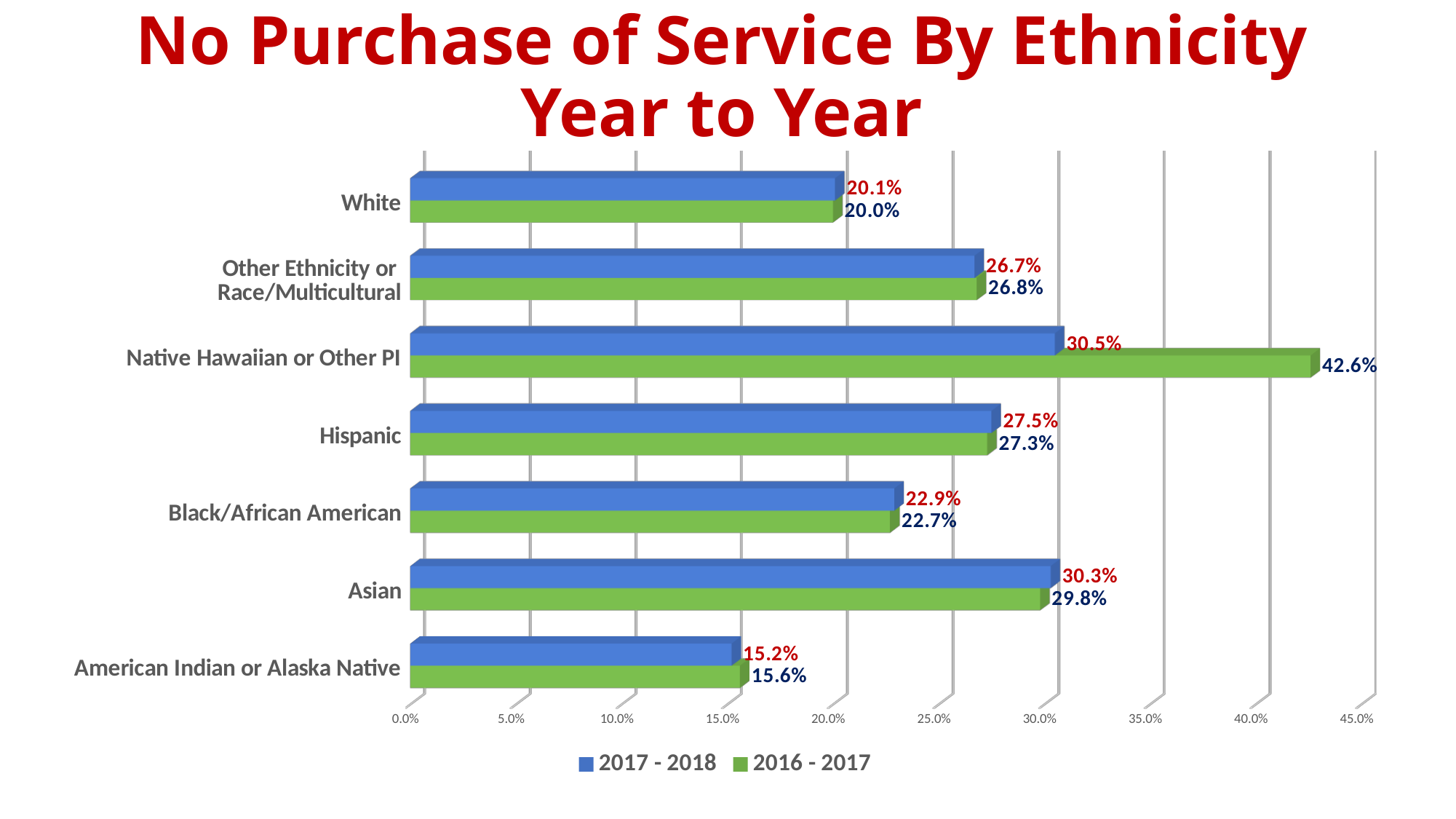
How many ethnicity categories are shown on the chart? 7 Which is larger for Asian: the 2017 - 2018 value or the 2016 - 2017 value? 2017 - 2018 What kind of chart is shown on the slide? Bar chart Is the 2016 - 2017 value for Native Hawaiian or Other PI greater or less than 40.0%? greater What is the 2016 - 2017 value for Asian? 29.8% How many series does the legend list? 2 Which category has the highest 2016 - 2017 value? Native Hawaiian or Other PI Which category has the lowest 2017 - 2018 value? American Indian or Alaska Native What is the difference between the 2016 - 2017 and 2017 - 2018 values for Native Hawaiian or Other PI? 12.1% What is the 2017 - 2018 value for Native Hawaiian or Other PI? 30.5% Which colour represents the 2016 - 2017 series? Green What is the 2017 - 2018 value for American Indian or Alaska Native? 15.2%